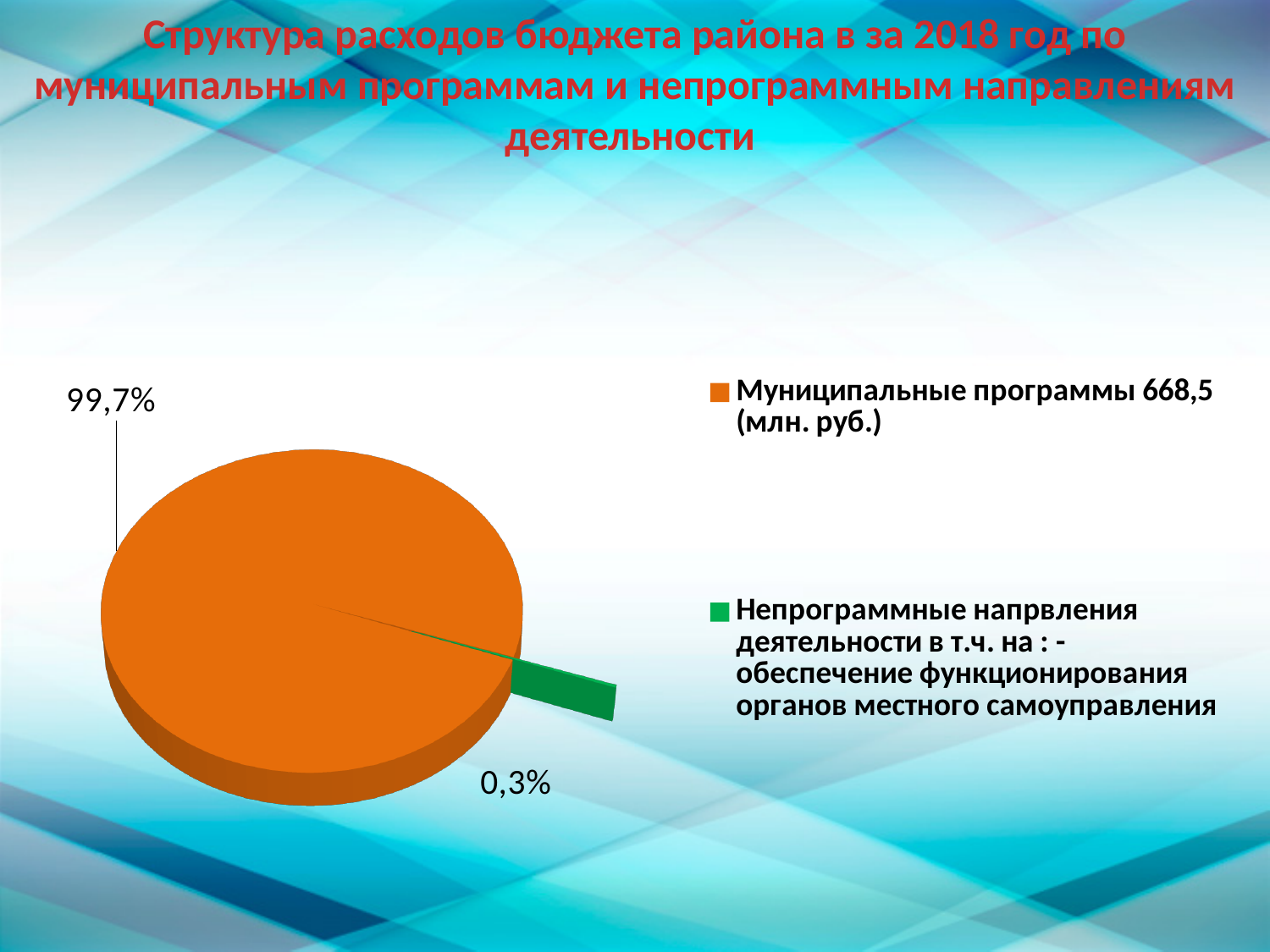
What kind of chart is shown on the slide? Pie chart Which slice of the pie is the largest? Муниципальные программы 668,5 (млн. руб.) What amount in million rubles is given in the legend for municipal programs? 668,5 What share of the pie is labelled for "Непрограммные напрвления деятельности"? 0,3% Which is larger: the share for municipal programs or the share for non-program directions? Муниципальные программы What share of the pie is labelled for "Муниципальные программы 668,5 (млн. руб.)"? 99,7% What colour is the slice for "Непрограммные напрвления деятельности"? Green Which slice of the pie is the smallest? Непрограммные напрвления деятельности How many slices does the pie chart have? 2 How many entries does the legend list? 2 What colour is the slice for "Муниципальные программы"? Orange What is the difference in percentage points between the 99,7% slice and the 0,3% slice? 99,4